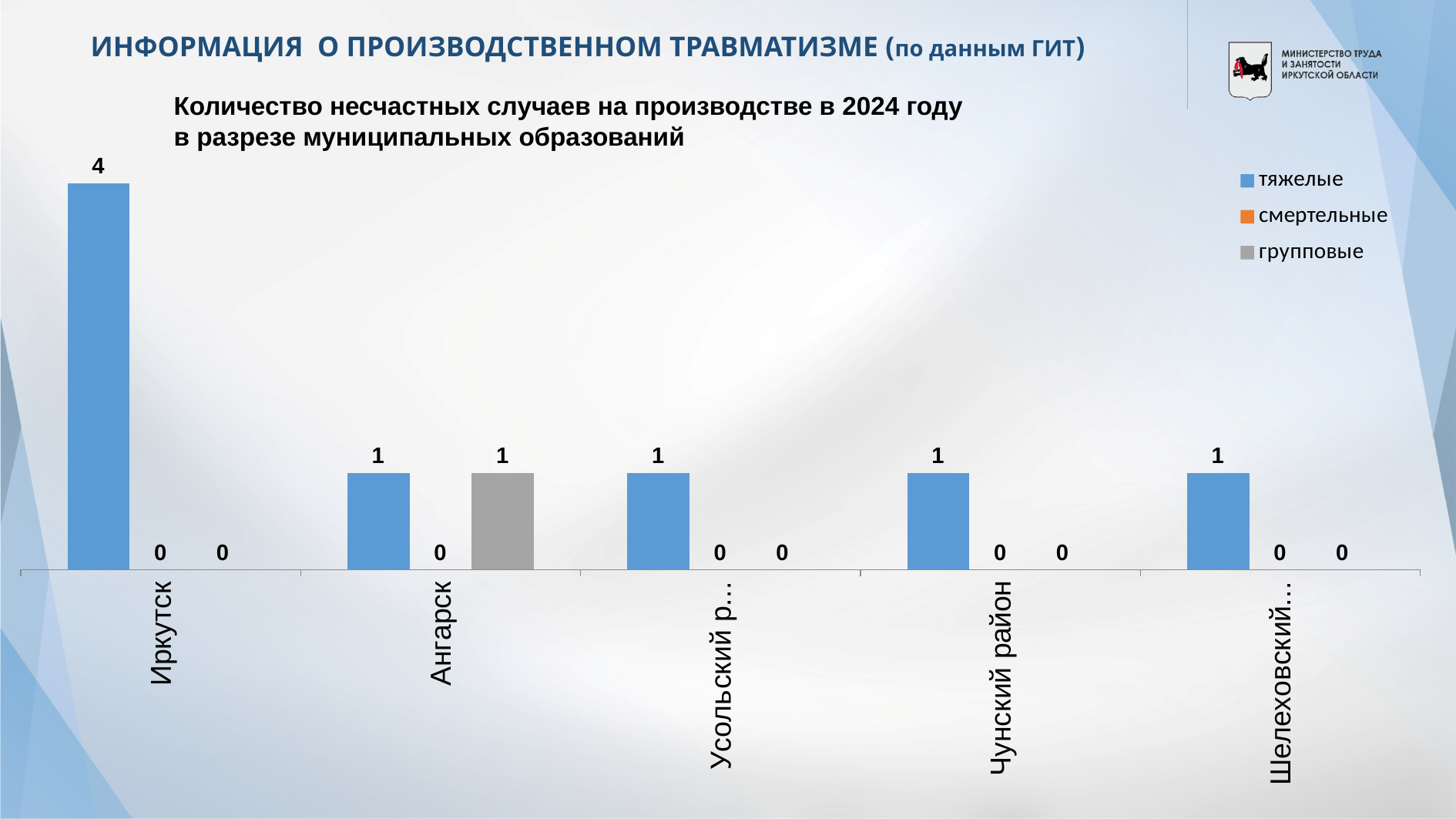
What is the value of тяжелые for Иркутск? 4 How many series does the legend list? 3 Which series is shown in gray in the legend? групповые What is the total of all three series for Ангарск? 2 Which category has the highest value for тяжелые? Иркутск What kind of chart is shown on the slide? bar chart What is the value of смертельные for Чунский район? 0 What is the difference between the тяжелые values for Иркутск and Ангарск? 3 Which is larger: the тяжелые value for Иркутск or the тяжелые value for Чунский район? Иркутск How many categories are shown on the x axis? 5 What is the value of тяжелые for Чунский район? 1 What is the value of групповые for Ангарск? 1